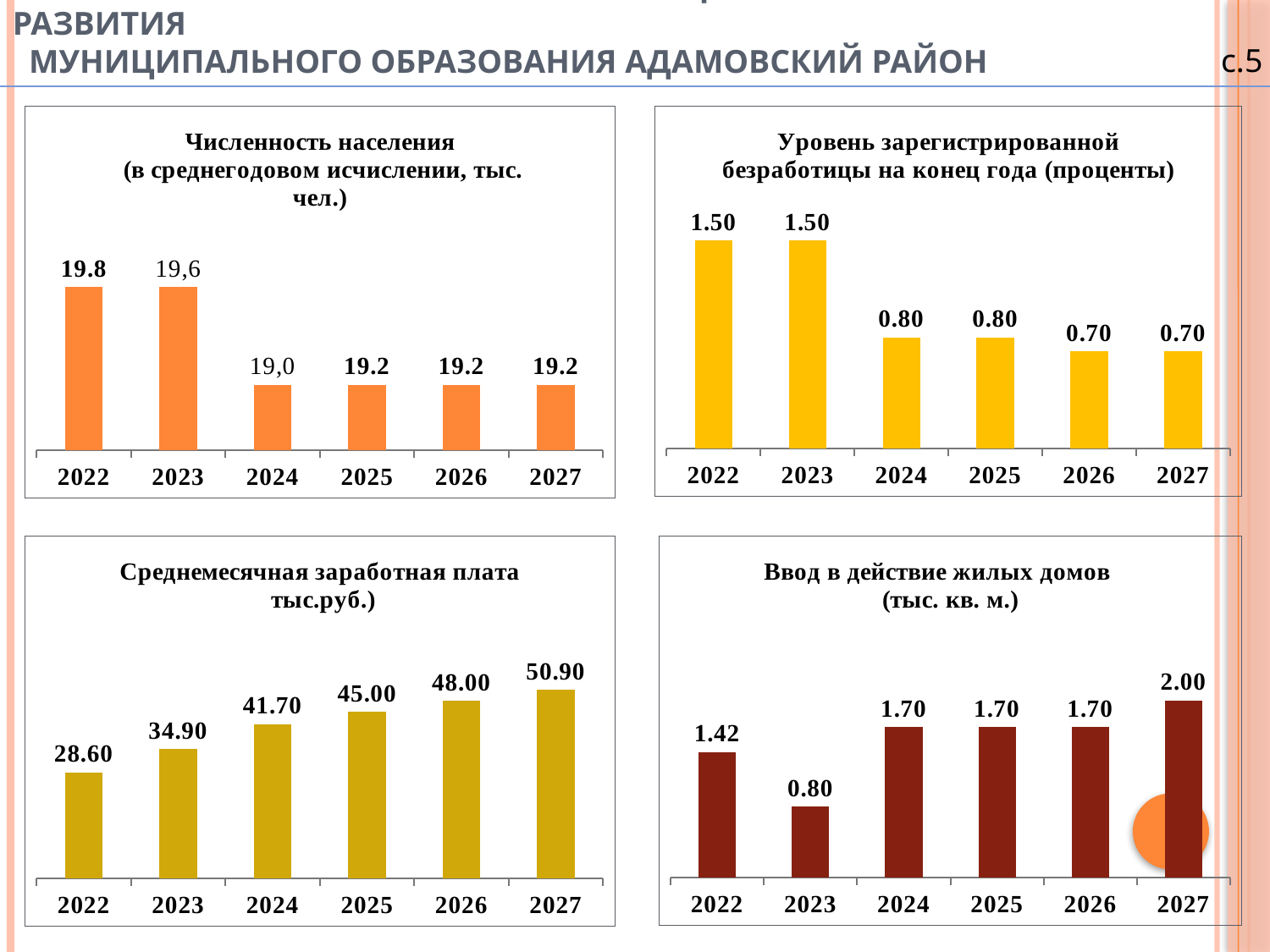
In the chart titled "Среднемесячная заработная плата", what is the difference between the values for 2027 and 2022? 22.30 In the chart titled "Ввод в действие жилых домов", which year has the highest value? 2027 In the chart titled "Численность населения", which year has the highest value? 2022 In the chart titled "Среднемесячная заработная плата", which year has the lowest value? 2022 In the chart titled "Среднемесячная заработная плата", what is the value for 2025? 45.00 In the chart titled "Среднемесячная заработная плата", do the values rise or fall from 2022 to 2027? rise In the chart titled "Уровень зарегистрированной безработицы на конец года", what is the difference between the values for 2022 and 2027? 0.80 In the chart titled "Уровень зарегистрированной безработицы на конец года", what is the value for 2024? 0.80 In the chart titled "Численность населения", what is the value for 2022? 19.8 In the chart titled "Ввод в действие жилых домов", which is larger, the value for 2022 or the value for 2023? 2022 How many years are shown on the x axis of the chart titled "Ввод в действие жилых домов"? 6 In the chart titled "Уровень зарегистрированной безработицы на конец года", do the values generally rise or fall from 2022 to 2027? fall